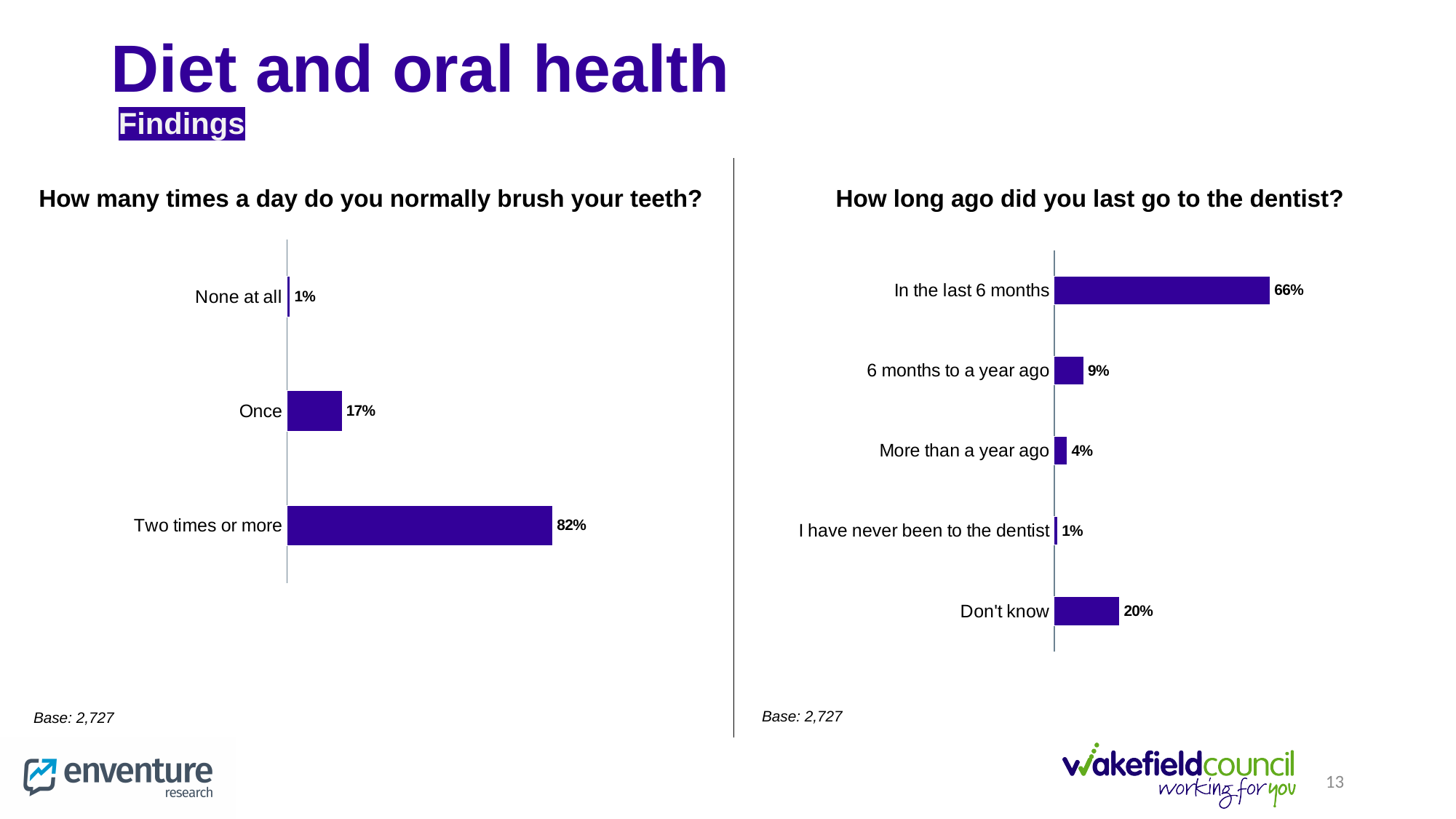
In the chart 'How many times a day do you normally brush your teeth?', which category has the lowest value? None at all In the chart 'How many times a day do you normally brush your teeth?', what is the difference between 'Two times or more' and 'Once'? 65% In the chart 'How long ago did you last go to the dentist?', which is larger: '6 months to a year ago' or 'More than a year ago'? 6 months to a year ago In the chart 'How long ago did you last go to the dentist?', which category has the highest value? In the last 6 months How many categories are shown in the chart 'How many times a day do you normally brush your teeth?' 3 In the chart 'How many times a day do you normally brush your teeth?', what is the value for 'Once'? 17% In the chart 'How long ago did you last go to the dentist?', what percentage of respondents went in the last 6 months? 66% What type of chart is used for 'How long ago did you last go to the dentist?' Bar chart How many categories are shown in the chart 'How long ago did you last go to the dentist?' 5 In the chart 'How many times a day do you normally brush your teeth?', what percentage of respondents brush their teeth two times or more? 82% In the chart 'How long ago did you last go to the dentist?', what is the value for 'Don't know'? 20% In the chart 'How long ago did you last go to the dentist?', what is the difference between 'Don't know' and '6 months to a year ago'? 11%